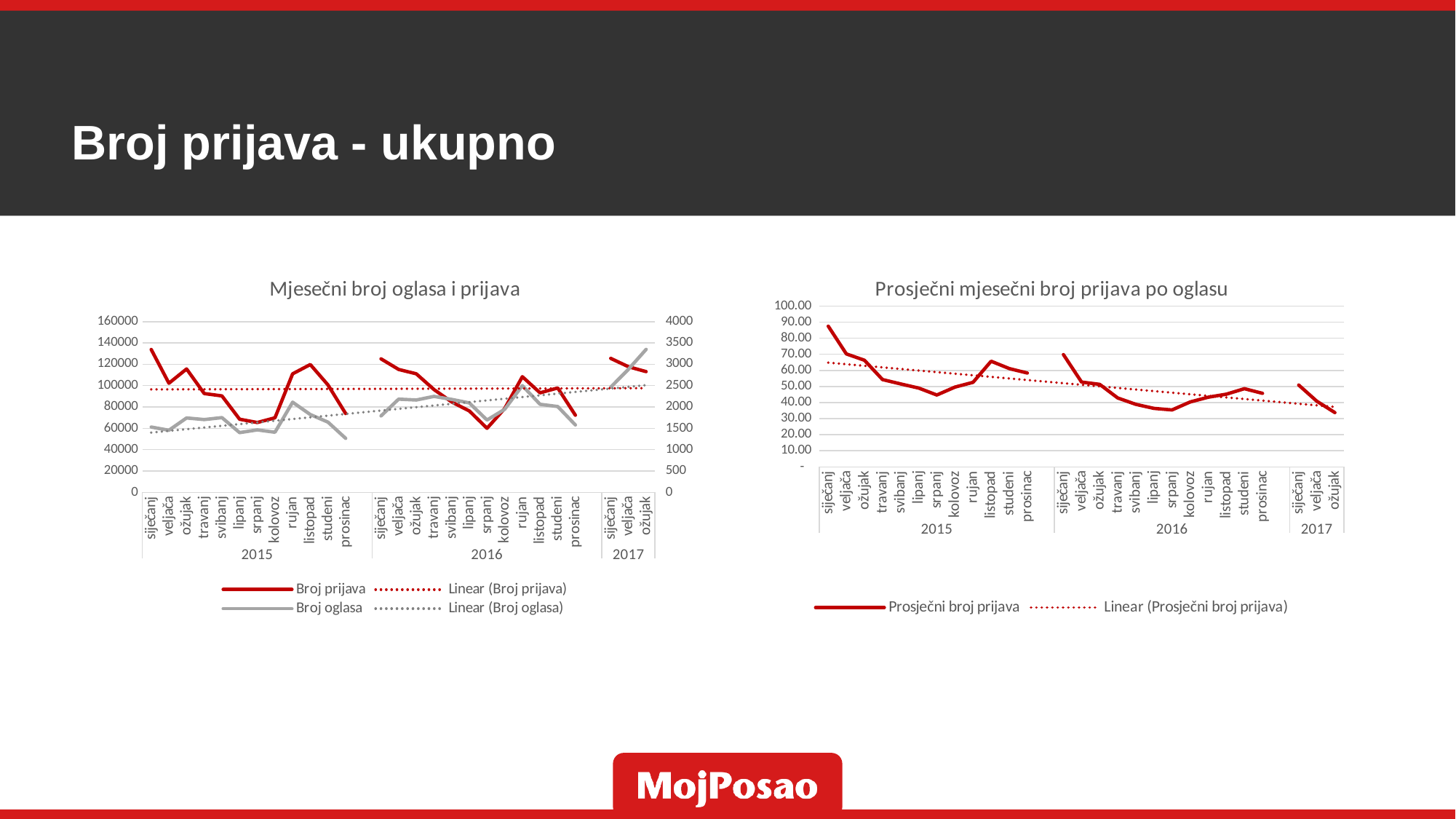
In the left chart "Mjesečni broj oglasa i prijava", is the Broj prijava value for srpanj 2016 greater or less than 80000? less In the right chart "Prosječni mjesečni broj prijava po oglasu", how many monthly data points are plotted? 27 What kind of chart is the left chart titled "Mjesečni broj oglasa i prijava"? line chart In the left chart "Mjesečni broj oglasa i prijava", how many entries does the legend list? 4 In the right chart "Prosječni mjesečni broj prijava po oglasu", how many entries does the legend list? 2 In the left chart "Mjesečni broj oglasa i prijava", which month has the highest value for Broj prijava? siječanj 2015 In the right chart "Prosječni mjesečni broj prijava po oglasu", which month has the highest value? siječanj 2015 In the right chart "Prosječni mjesečni broj prijava po oglasu", is the value for ožujak 2017 greater or less than 40.00? less In the right chart "Prosječni mjesečni broj prijava po oglasu", do the values generally rise or fall from 2015 to 2017? fall What kind of chart is the right chart titled "Prosječni mjesečni broj prijava po oglasu"? line chart In the right chart "Prosječni mjesečni broj prijava po oglasu", is the value for siječanj 2015 greater or less than 80.00? greater In the left chart "Mjesečni broj oglasa i prijava", which series is drawn in grey? Broj oglasa